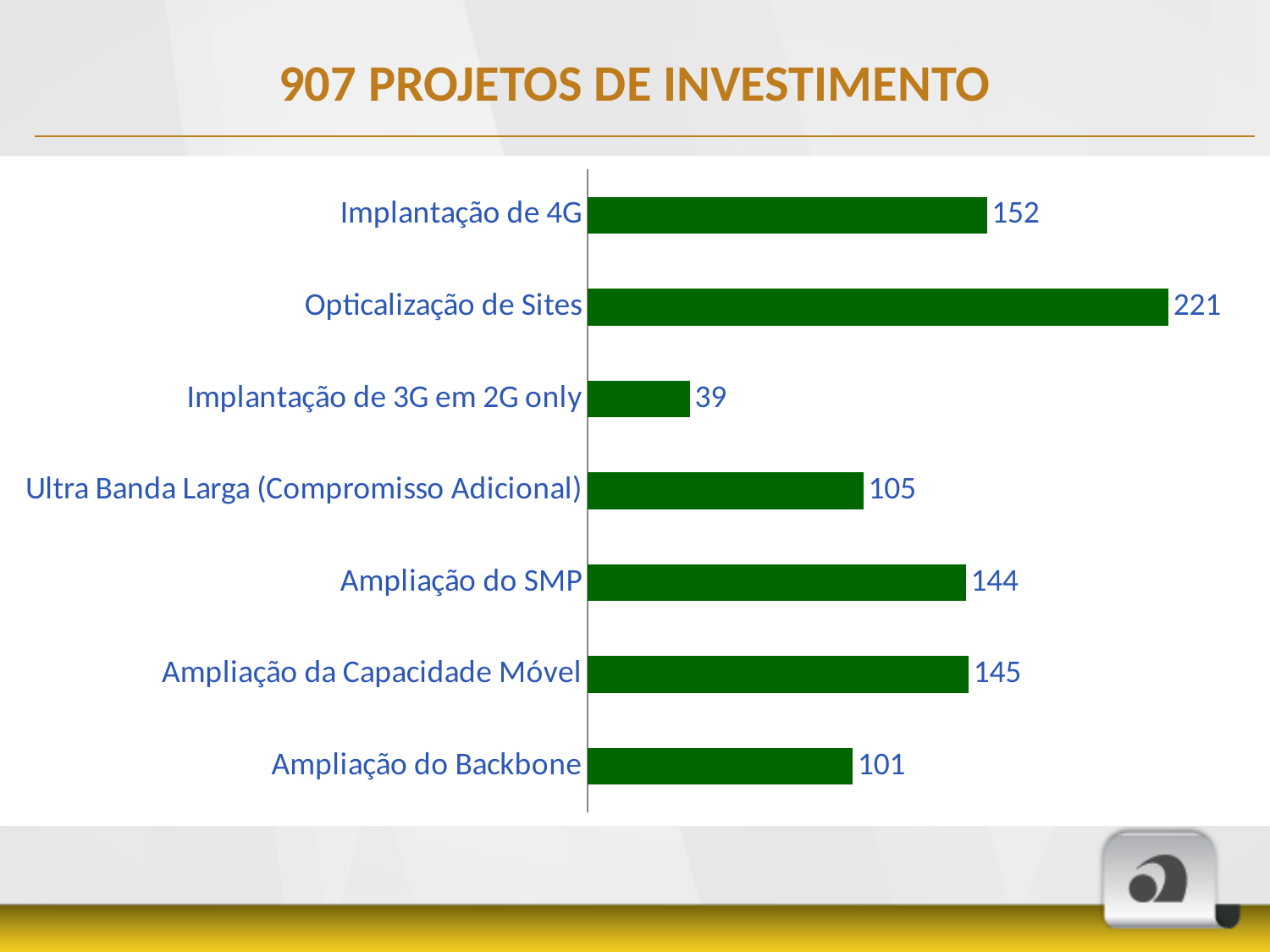
What is the value for Implantação de 4G? 152 What is the value for Ampliação do Backbone? 101 What kind of chart is shown on the slide? Bar chart Which category has the lowest value? Implantação de 3G em 2G only How many categories are shown in the chart? 7 Which is larger, the value for Implantação de 4G or the value for Ultra Banda Larga (Compromisso Adicional)? Implantação de 4G What is the value for Implantação de 3G em 2G only? 39 What is the difference between the values for Opticalização de Sites and Implantação de 4G? 69 Which category has the highest value? Opticalização de Sites What is the difference between the values for Ampliação da Capacidade Móvel and Ampliação do SMP? 1 What is the value for Ultra Banda Larga (Compromisso Adicional)? 105 What is the value for Opticalização de Sites? 221